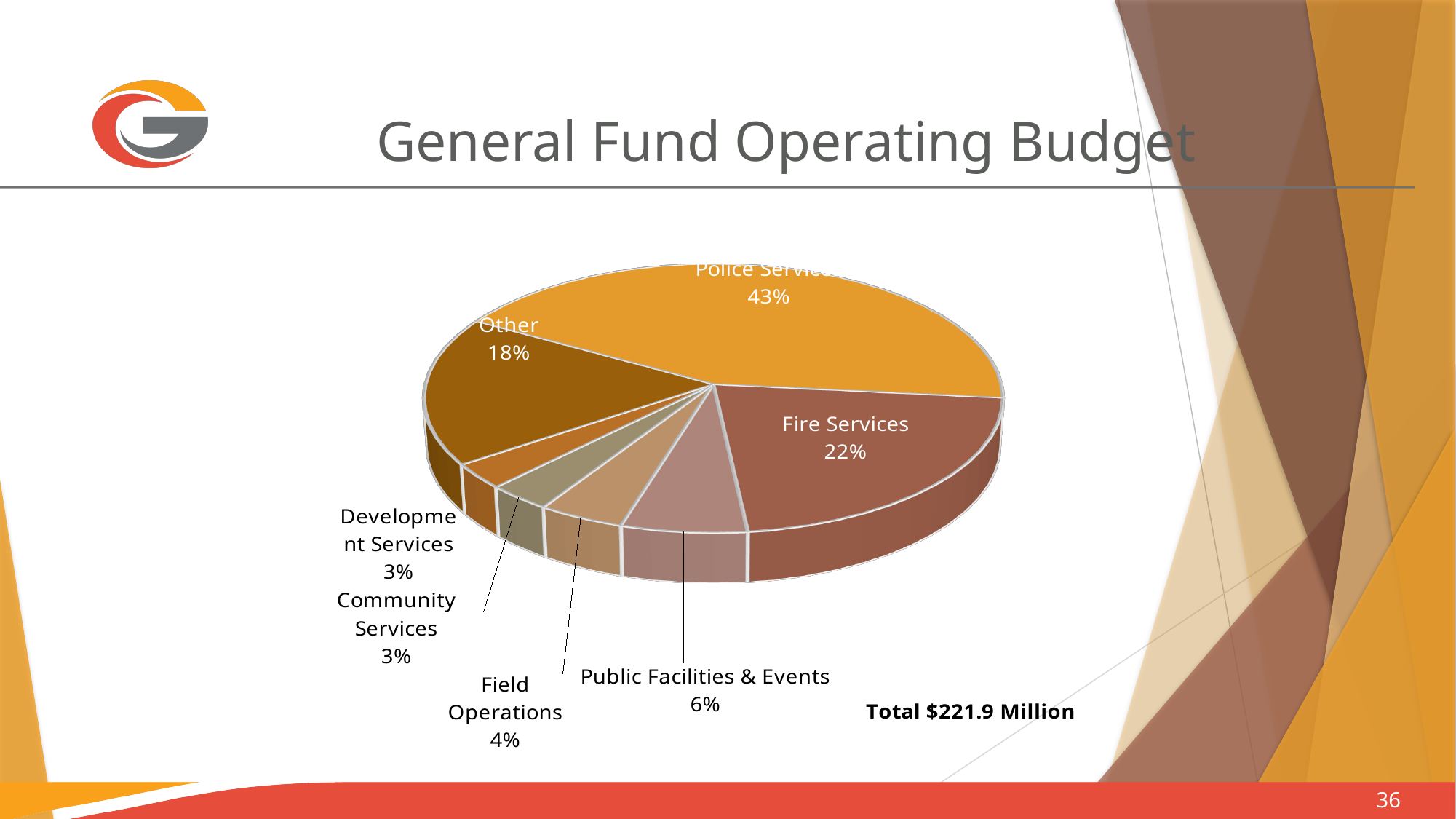
What is the total General Fund Operating Budget stated on the slide? $221.9 Million Which category has the largest share of the General Fund Operating Budget? Police Services What share of the budget goes to Field Operations? 4% What percentage of the budget is labelled Other? 18% What share of the budget is Fire Services? 22% What kind of chart is shown on the slide? pie chart What is the title of the slide containing the pie chart? General Fund Operating Budget How many slices does the pie chart have? 7 Which is larger, the share for Fire Services or the share for Other? Fire Services What is the difference in percentage points between Police Services and Fire Services? 21